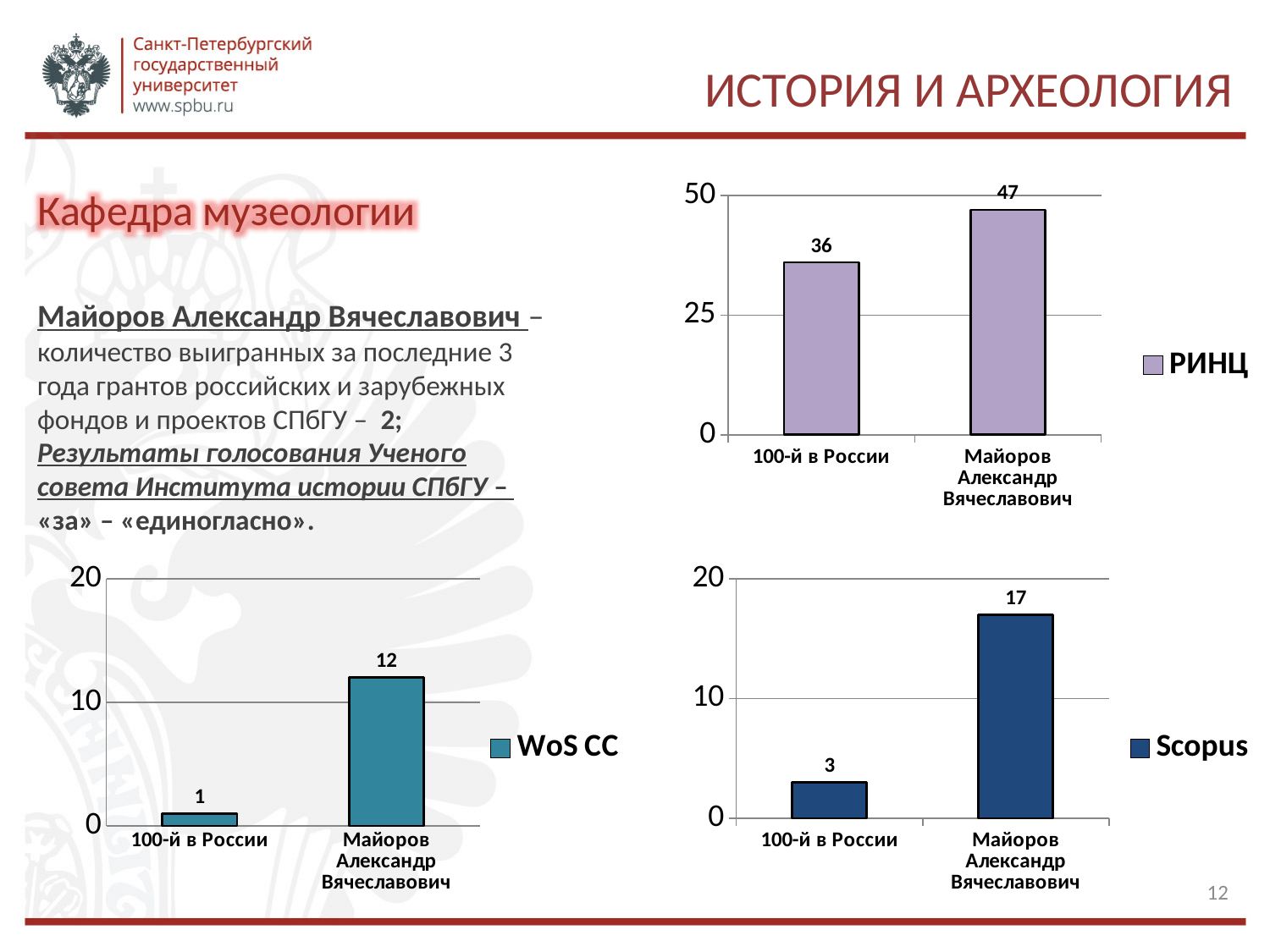
In the WoS CC chart (bottom left), which category has the lowest value? 100-й в России How many categories are shown in the РИНЦ chart (top right)? 2 In the Scopus chart (bottom right), what is the value for 100-й в России? 3 In the WoS CC chart (bottom left), what is the value for Майоров Александр Вячеславович? 12 In the Scopus chart (bottom right), what is the difference between Майоров Александр Вячеславович and 100-й в России? 14 In the РИНЦ chart (top right), what is the value for 100-й в России? 36 What kind of chart is the WoS CC chart (bottom left)? Bar chart In the Scopus chart (bottom right), what is the value for Майоров Александр Вячеславович? 17 In the РИНЦ chart (top right), what is the difference between Майоров Александр Вячеславович and 100-й в России? 11 In the РИНЦ chart (top right), what is the value for Майоров Александр Вячеславович? 47 In the Scopus chart (bottom right), which category has the highest value? Майоров Александр Вячеславович In the WoS CC chart (bottom left), what is the value for 100-й в России? 1